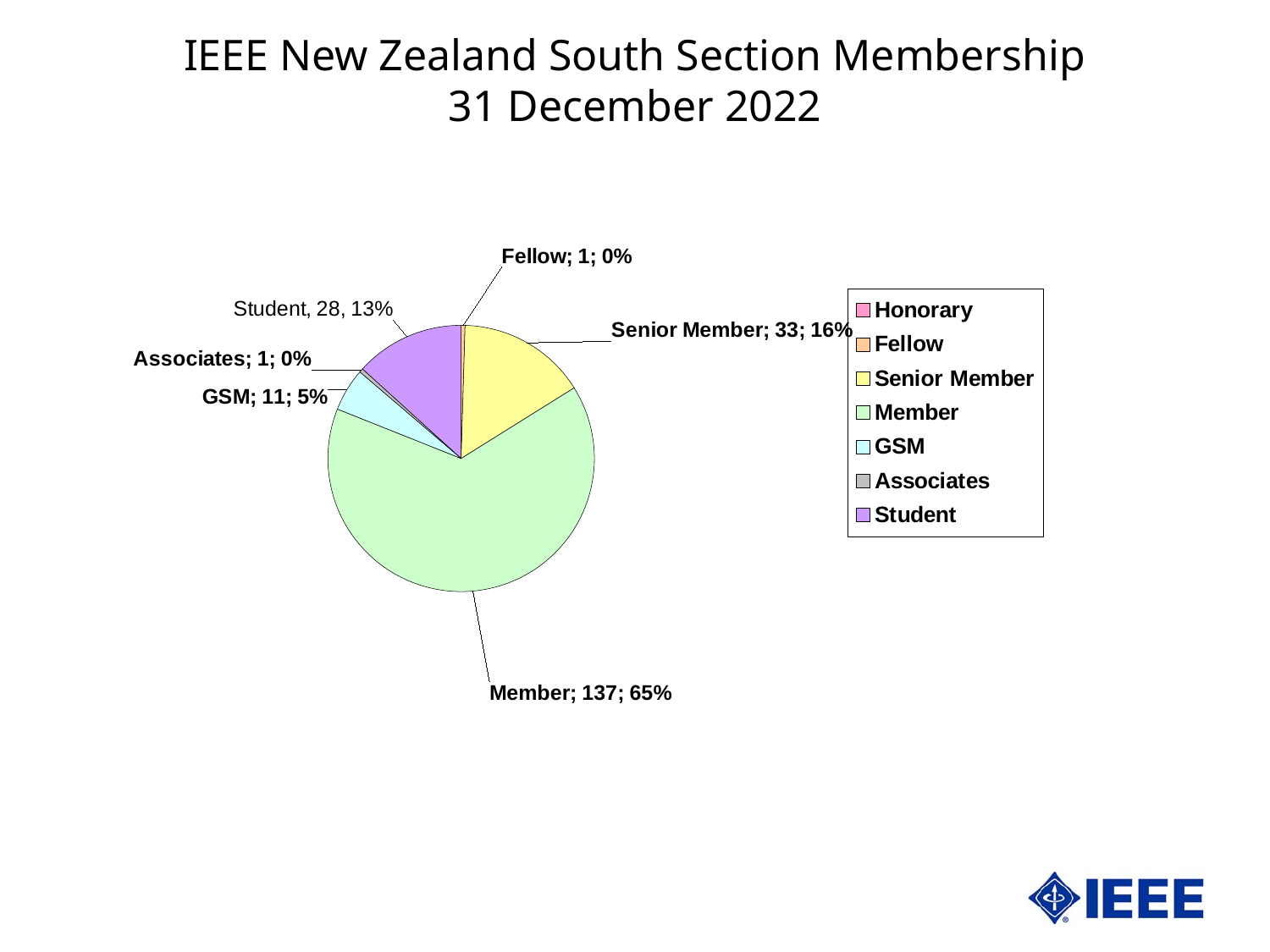
How many Fellows are shown in the chart? 1 How many members are in the Member category? 137 What is the title of the slide? IEEE New Zealand South Section Membership 31 December 2022 How many entries does the legend list? 7 What is the difference between the GSM count and the Associates count? 10 What kind of chart is shown on the slide? pie chart Which is larger, the Student count or the Senior Member count? Senior Member What is the difference between the number of Members and the number of Senior Members? 104 What share of the pie does the Student slice represent? 13% Which category has the largest slice of the pie? Member How many members are in the GSM category? 11 What share of the pie does the Senior Member slice represent? 16%